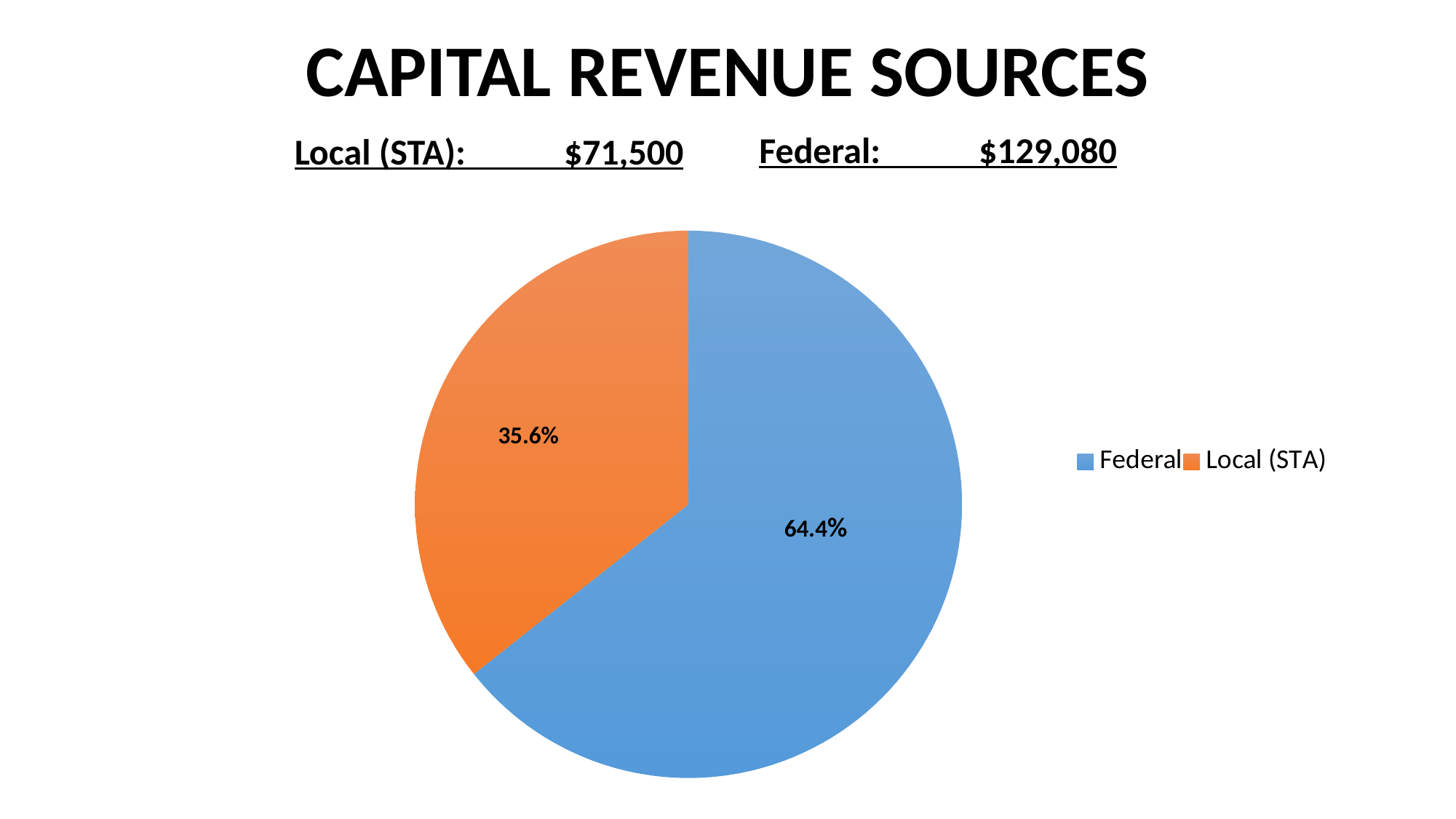
Which revenue source has the largest slice of the pie? Federal What dollar amount is shown for Federal capital revenue? $129,080 What is the difference in percentage points between the Federal and Local (STA) slices? 28.8 What colour is the Local (STA) slice in the pie chart? orange What kind of chart is shown on the slide? pie chart What dollar amount is shown for Local (STA) capital revenue? $71,500 What share of the pie does the Local (STA) slice represent? 35.6% How many entries does the legend list? 2 Which revenue source has the smallest slice of the pie? Local (STA) What share of the pie does the Federal slice represent? 64.4% How many slices does the pie chart have? 2 Which slice is larger, Federal or Local (STA)? Federal